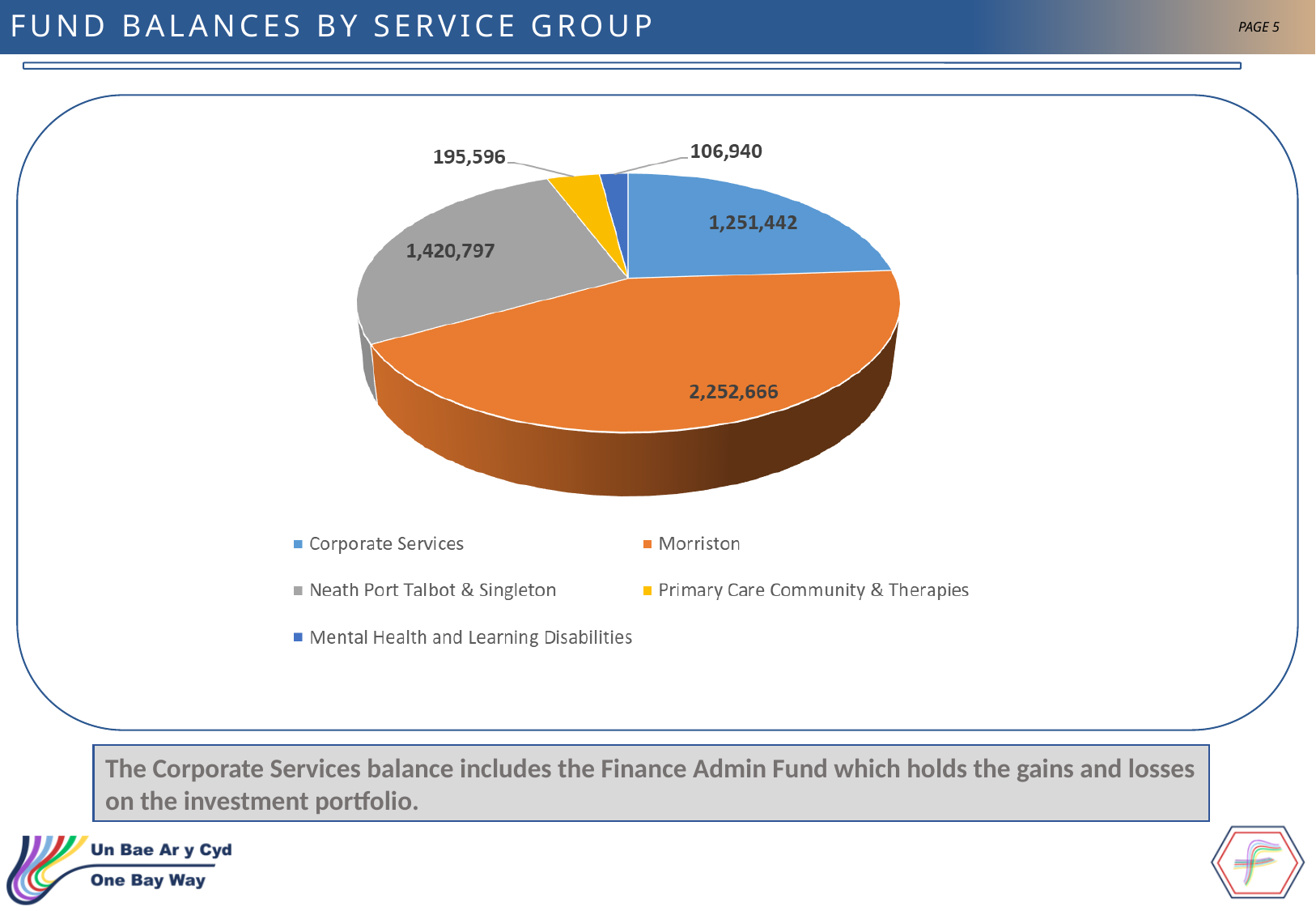
What type of chart is shown on the slide? Pie chart Which service group has the largest fund balance? Morriston What is the difference between the fund balances of Primary Care Community & Therapies and Mental Health and Learning Disabilities? 88,656 How many service groups are shown in the pie chart? 5 What is the fund balance for Neath Port Talbot & Singleton? 1,420,797 What is the fund balance for Corporate Services? 1,251,442 What is the fund balance for Mental Health and Learning Disabilities? 106,940 What colour is the Primary Care Community & Therapies slice? Yellow Which has the larger fund balance, Neath Port Talbot & Singleton or Corporate Services? Neath Port Talbot & Singleton Which service group has the smallest fund balance? Mental Health and Learning Disabilities What is the fund balance for Morriston? 2,252,666 What is the difference between the fund balances of Morriston and Corporate Services? 1,001,224